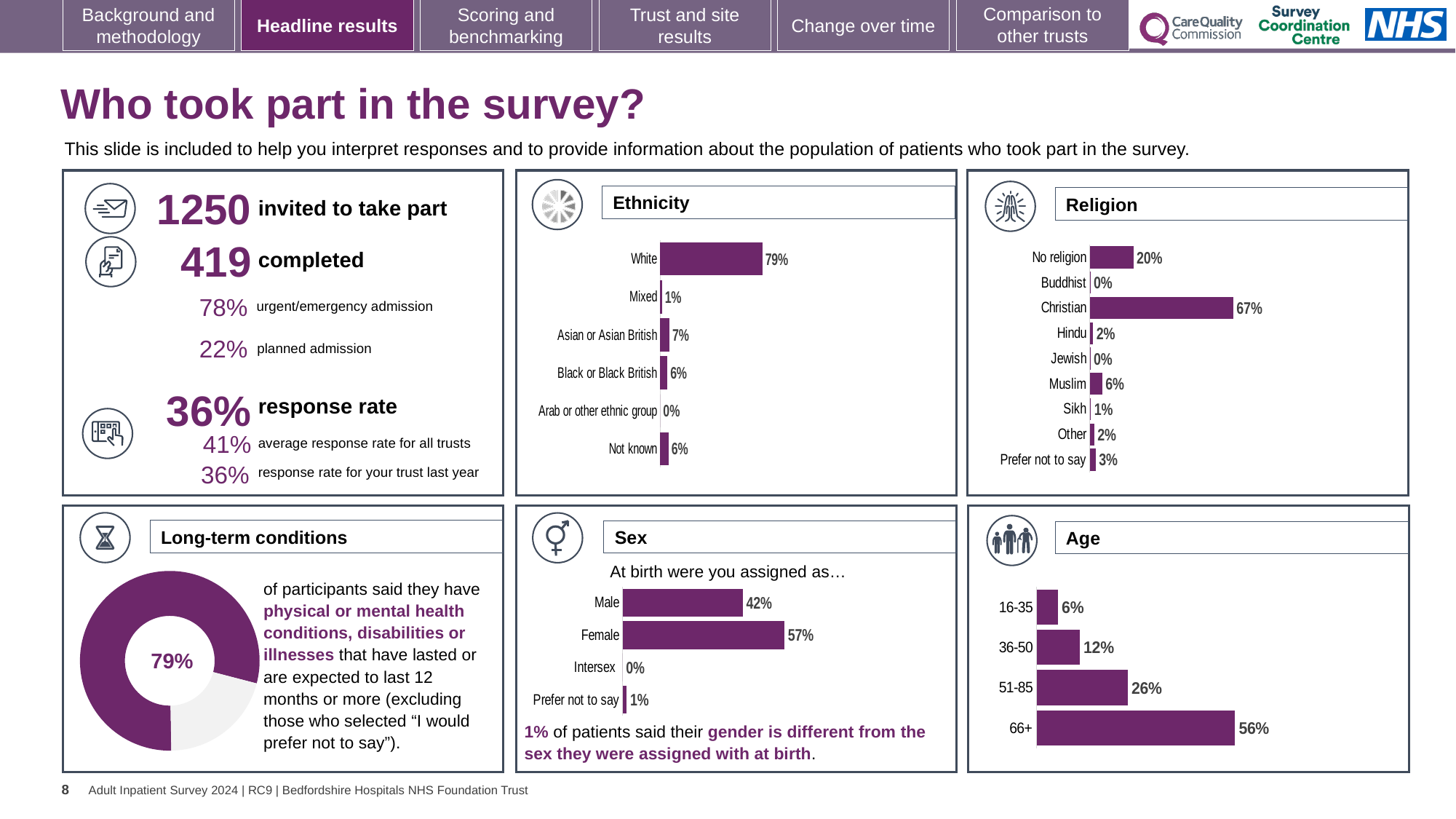
In the Ethnicity chart, which category has the highest value? White In the Sex chart, what percentage of respondents were Female? 57% In the Sex chart, what is the difference between the Female and Male values? 15% What kind of chart is the Long-term conditions chart? doughnut chart In the Age chart, do the values rise or fall as you move from 16-35 to 66+? rise In the Ethnicity chart, what percentage of respondents were White? 79% In the Religion chart, which is larger, Muslim or Hindu? Muslim In the Religion chart, what percentage of respondents were Christian? 67% In the Religion chart, how many categories are shown? 9 In the Ethnicity chart, how many categories are shown? 6 In the Religion chart, what is the difference between the Christian and No religion values? 47% In the Age chart, which age group has the highest value? 66+